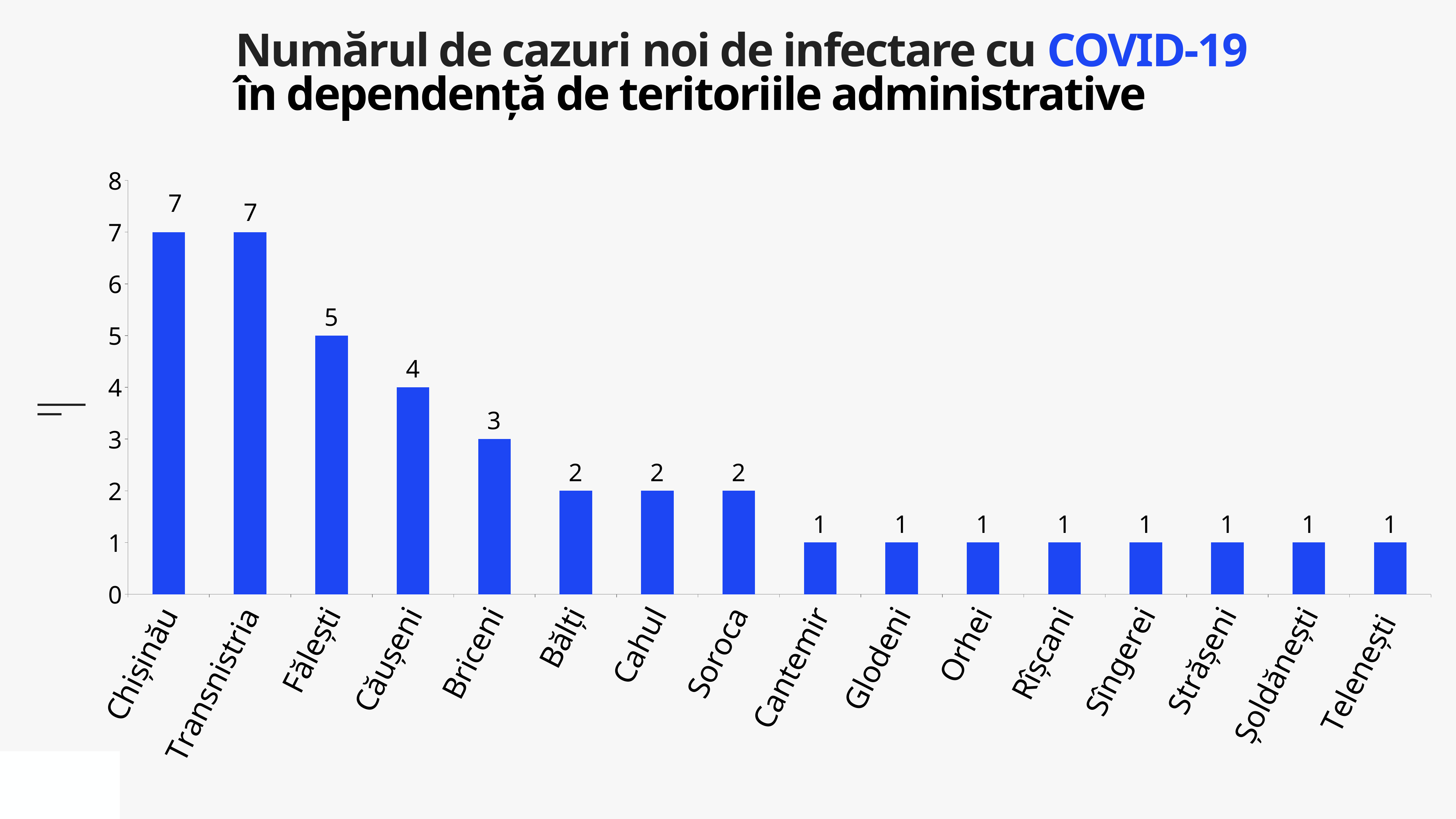
What is the value for Orhei? 1 What is the difference between the values for Căușeni and Bălți? 2 How many categories are shown on the x axis? 16 What is the value for Soroca? 2 What kind of chart is shown on the slide? Bar chart What is the value for Briceni? 3 What is the value for Căușeni? 4 Do the values rise or fall from left to right along the x axis? Fall Which is larger, the value for Transnistria or the value for Briceni? Transnistria What is the highest value shown on the chart? 7 What is the value for Fălești? 5 What is the difference between the values for Chișinău and Fălești? 2